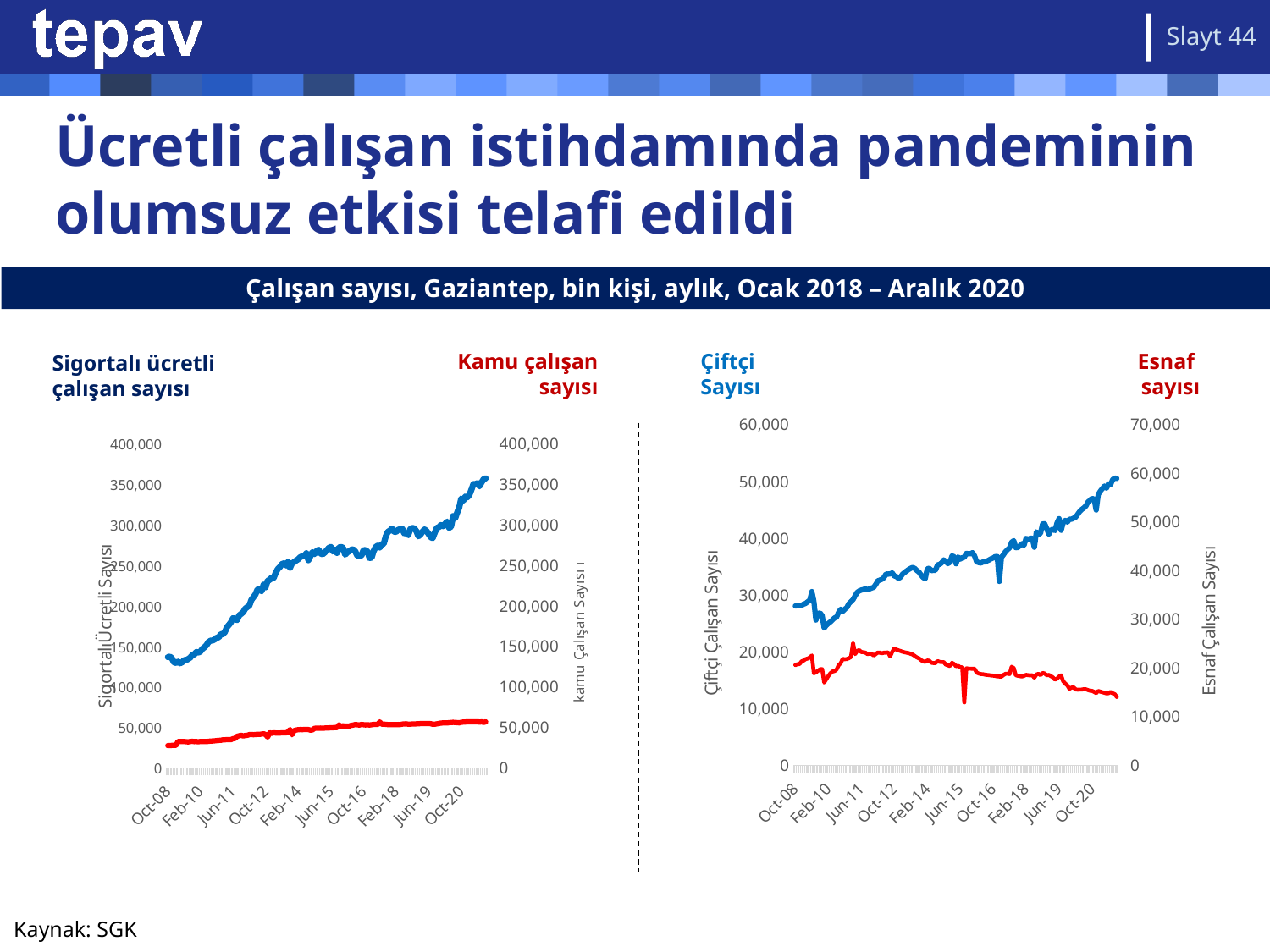
In the left chart, is the value of Sigortalı ücretli çalışan sayısı at Oct-20 greater or less than 300,000? greater What kind of chart is the right chart (Çiftçi Sayısı / Esnaf sayısı)? line chart How many series are plotted in the right chart? 2 In the left chart, which series is higher at Oct-20: Sigortalı ücretli çalışan sayısı or Kamu çalışan sayısı? Sigortalı ücretli çalışan sayısı In the left chart, does the Sigortalı ücretli çalışan sayısı (blue line) rise or fall from Oct-08 to Oct-20? rise What kind of chart is the left chart (Sigortalı ücretli çalışan sayısı / Kamu çalışan sayısı)? line chart What is the title shown above the charts? Çalışan sayısı, Gaziantep, bin kişi, aylık, Ocak 2018 – Aralık 2020 In the left chart, is the Kamu çalışan sayısı (red line) at Oct-20 greater or less than 100,000 on the right axis? less